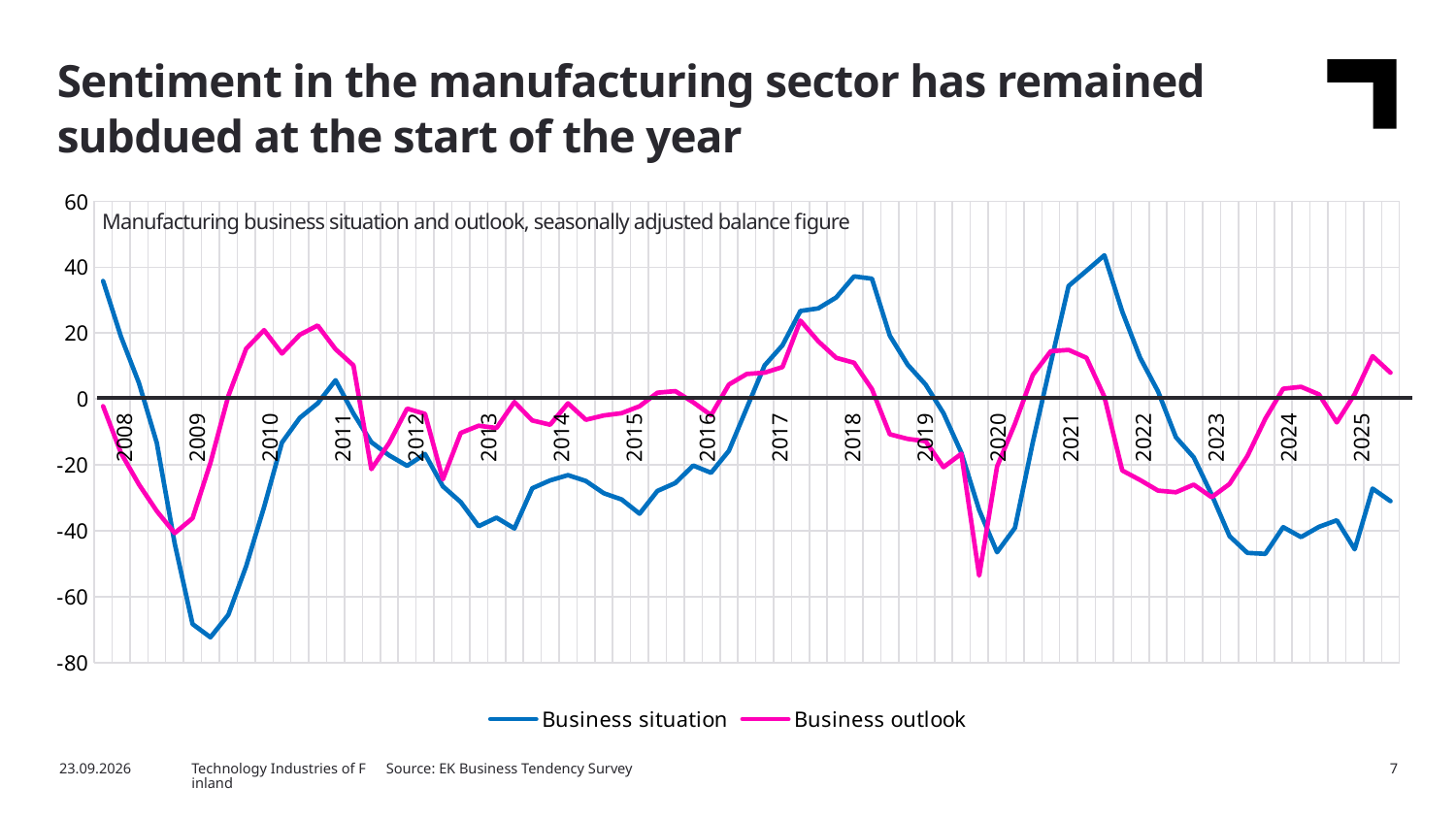
Around 2018, which series has the higher value, Business situation or Business outlook? Business situation What is the title printed inside the chart area? Manufacturing business situation and outlook, seasonally adjusted balance figure Is the value for Business situation at the end of the series in 2025 greater or less than -20? less Around 2009, which series has the higher value, Business situation or Business outlook? Business outlook Is the value for Business situation at its peak around 2021 greater or less than 20? greater Which colour is used for the Business outlook line? Pink Is the value for Business situation at its low point around 2009 greater or less than -60? less How many year labels are shown on the x axis? 18 How many series does the legend list? 2 What kind of chart is shown on the slide? Line chart